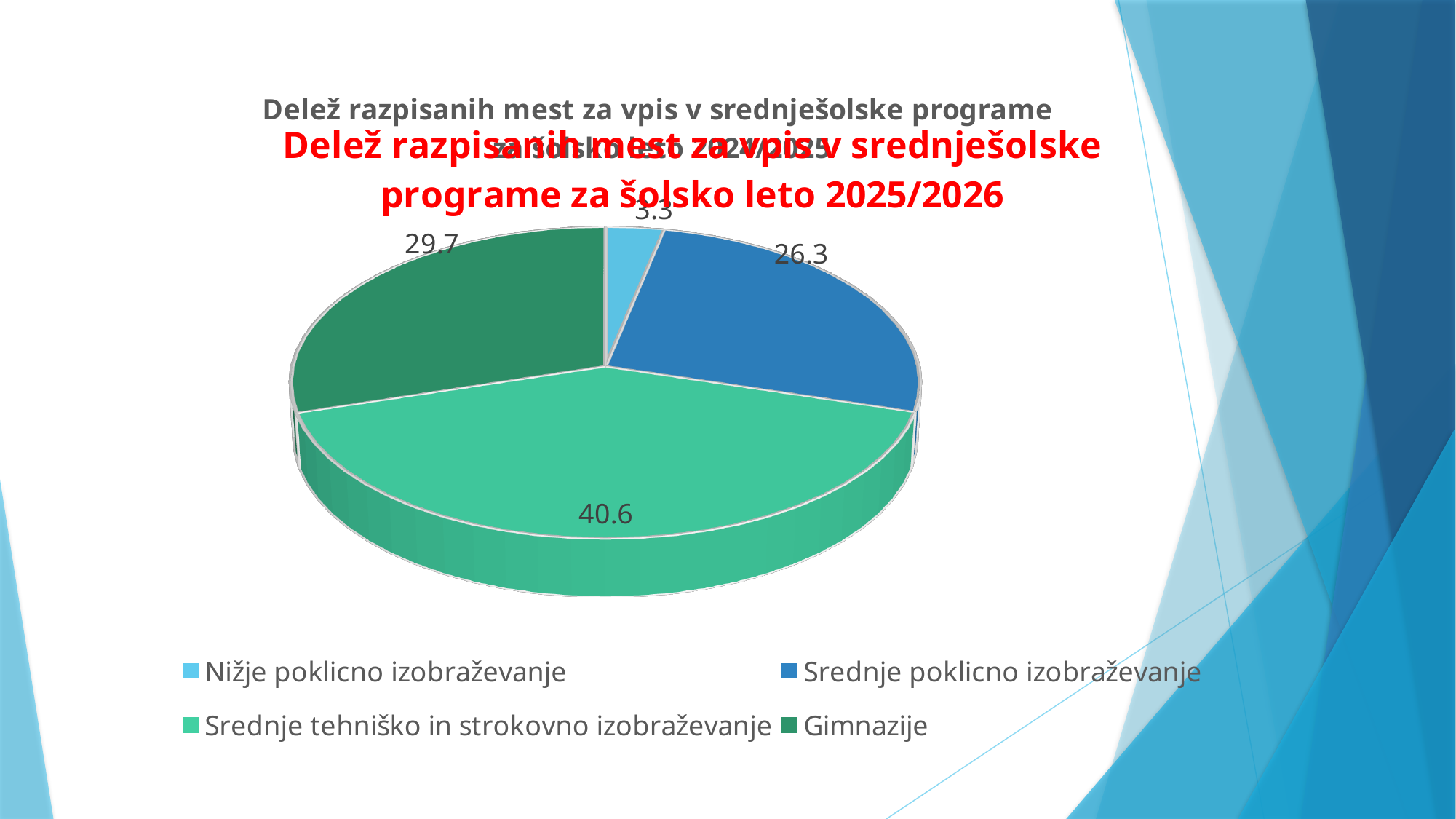
Which category has the smallest slice of the pie? Nižje poklicno izobraževanje What is the value shown for Nižje poklicno izobraževanje? 3.3 Which is larger, the value for Gimnazije or the value for Srednje poklicno izobraževanje? Gimnazije How many entries does the legend list? 4 How many slices does the pie chart have? 4 What is the difference between the values for Srednje poklicno izobraževanje and Nižje poklicno izobraževanje? 23 Which category has the largest slice of the pie? Srednje tehniško in strokovno izobraževanje What is the value shown for Gimnazije? 29.7 What is the difference between the values for Srednje tehniško in strokovno izobraževanje and Gimnazije? 10.9 What is the value shown for Srednje tehniško in strokovno izobraževanje? 40.6 What kind of chart is shown on the slide? pie chart What is the value shown for Srednje poklicno izobraževanje? 26.3